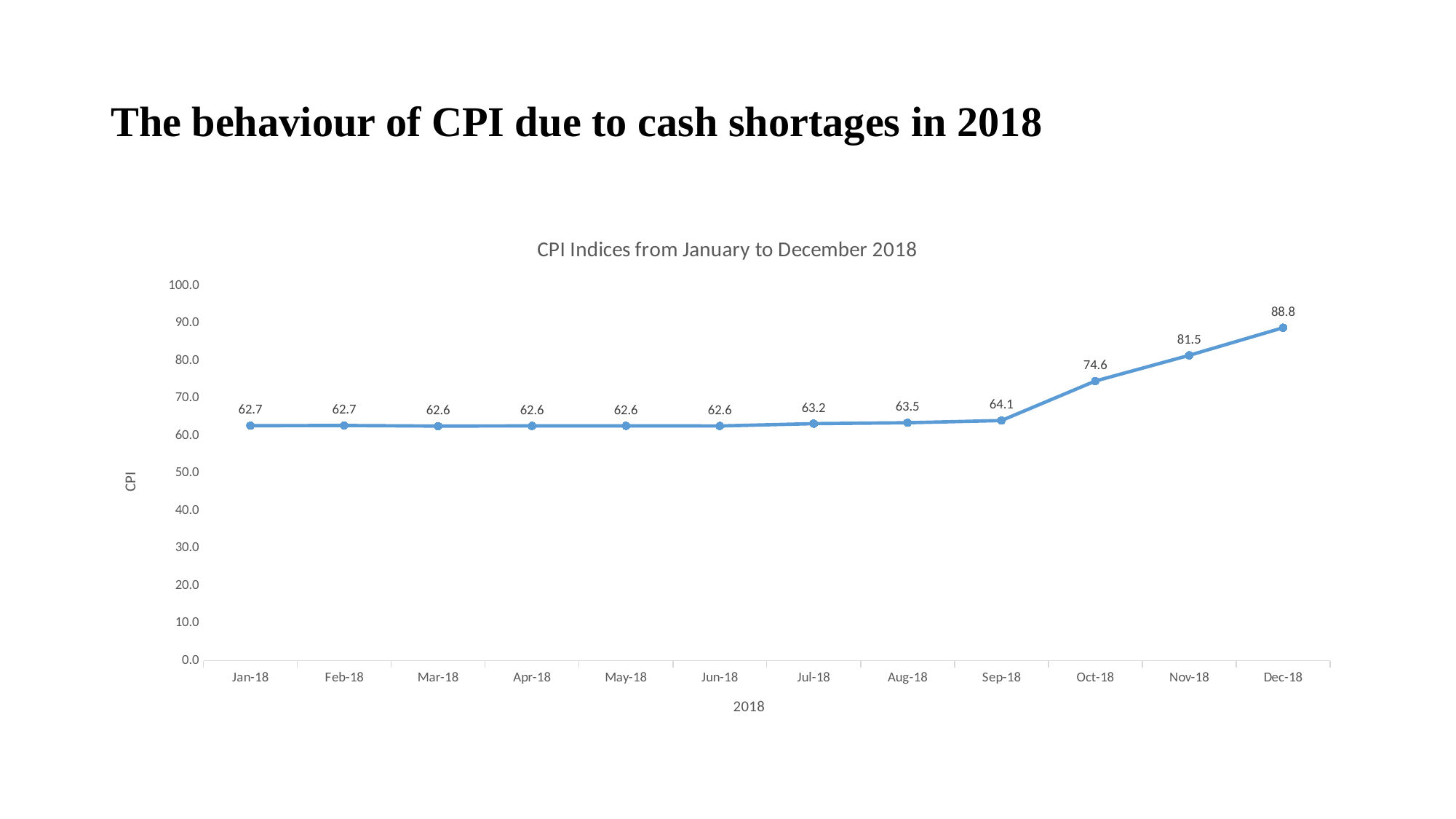
What is the CPI value for Oct-18? 74.6 Which is larger, the CPI value for Aug-18 or for Nov-18? Nov-18 How many months are plotted on the chart? 12 Do the CPI values rise or fall from Sep-18 to Dec-18? rise What is the difference between the CPI values for Oct-18 and Sep-18? 10.5 What is the difference between the CPI values for Dec-18 and Nov-18? 7.3 What is the title of the chart? CPI Indices from January to December 2018 Which month has the highest CPI value? Dec-18 What is the CPI value for Jul-18? 63.2 What kind of chart is shown on the slide? line chart Is the CPI value for Nov-18 greater or less than 70.0? greater What is the CPI value for Dec-18? 88.8